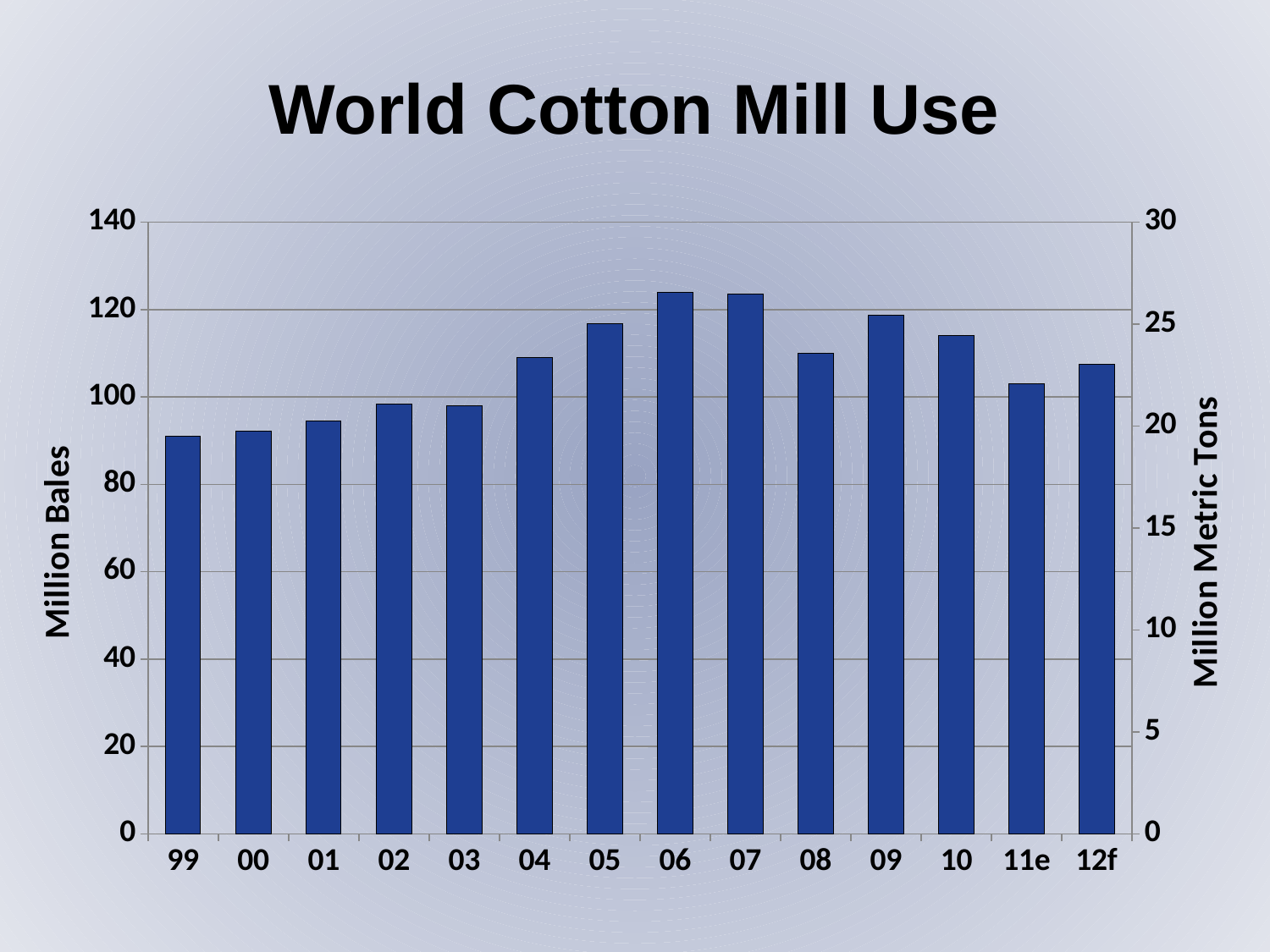
Do the values generally rise or fall from 99 to 06? rise Which year has the larger value, 06 or 99? 06 Is the value for 01 greater or less than 100 million bales? less What type of chart is shown on the slide? bar chart How many bars (years) are plotted in the chart? 14 Which year has the larger value, 10 or 12f? 10 Is the value for 04 greater or less than 100 million bales? greater Is the value for 99 greater or less than 100 million bales? less Which year has the larger value, 09 or 08? 09 What is the title of the chart? World Cotton Mill Use What is the label of the left vertical axis? Million Bales